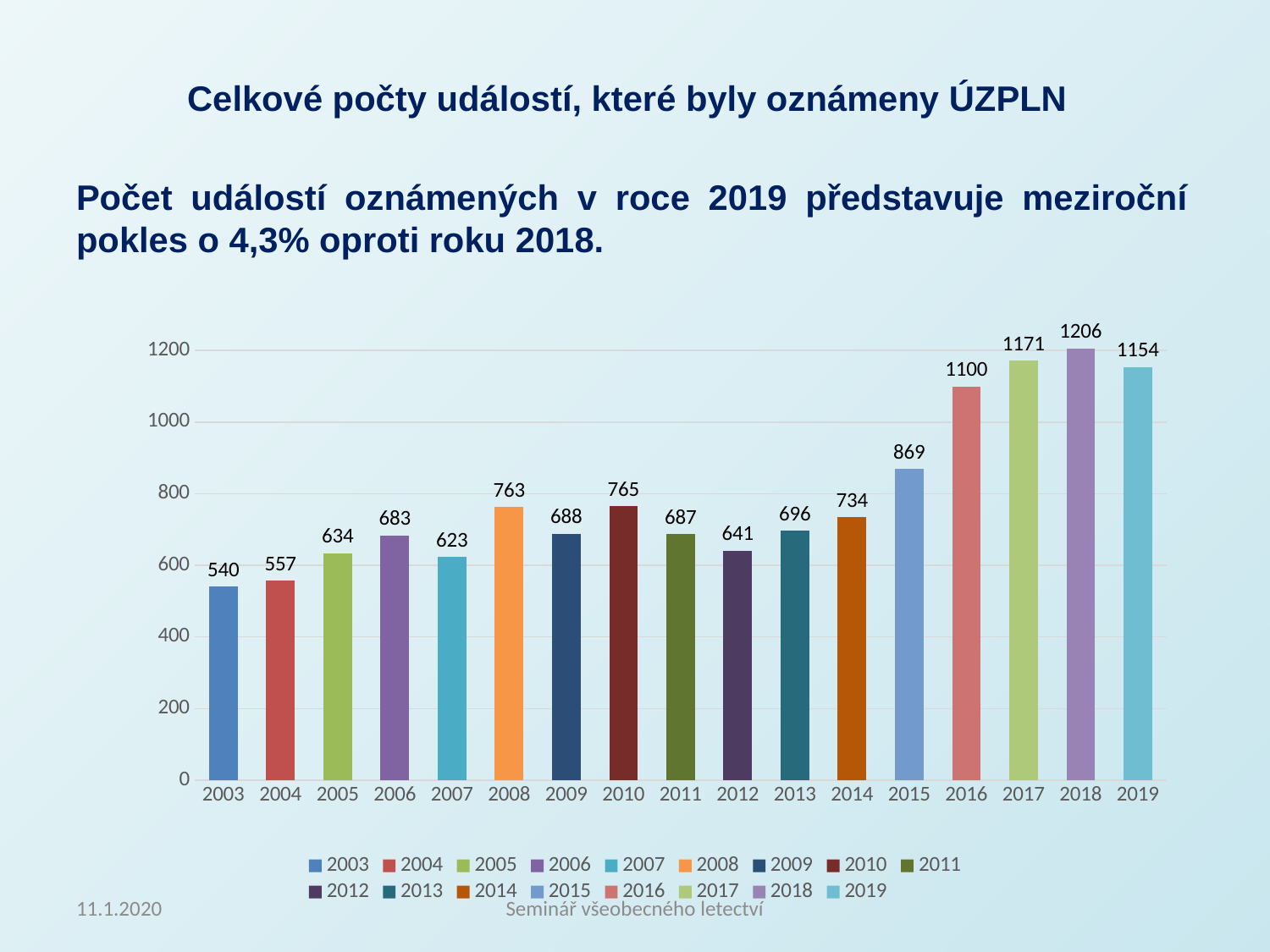
What is the value for 2015? 869 What is the value for 2019? 1154 What is the value for 2003? 540 How many entries does the legend list? 17 How many years are shown on the x axis? 17 What is the difference between the values for 2016 and 2015? 231 Is the value for 2012 greater or less than 600? greater Which year has the highest value? 2018 Which year has the lowest value? 2003 What is the difference between the values for 2018 and 2019? 52 What kind of chart is shown on the slide? bar chart Which is larger, the value for 2008 or the value for 2010? 2010